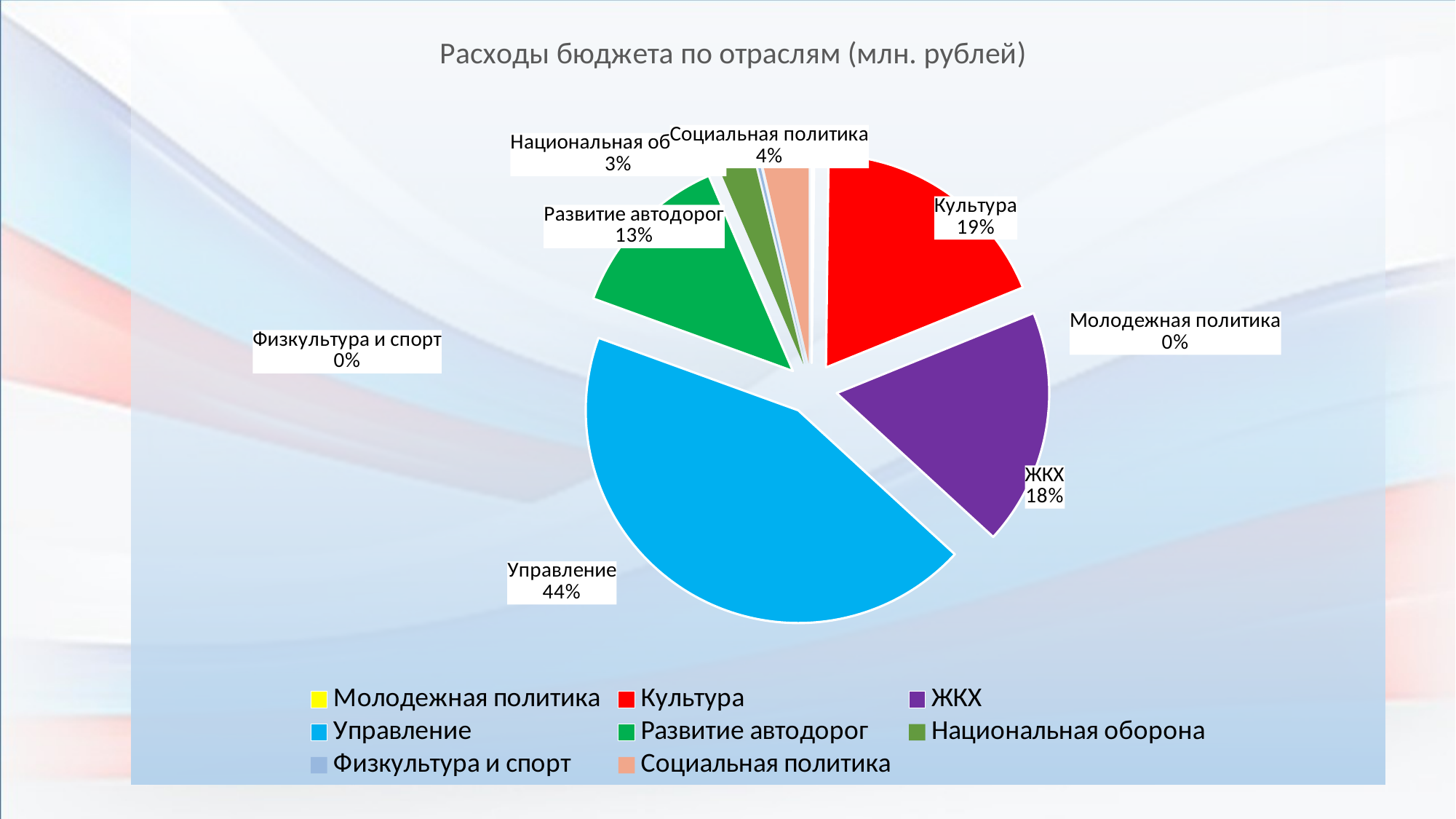
How many categories does the legend list? 8 What percentage is labelled for Социальная политика? 4% What type of chart is shown on the slide? Pie chart Which category has the largest share of the pie? Управление What share of the pie does Управление have? 44% What is the title of the chart? Расходы бюджета по отраслям (млн. рублей) What share is shown for Развитие автодорог? 13% What is the value labelled for ЖКХ? 18% What is the difference in percentage points between Культура and ЖКХ? 1% Which is larger, the share for Культура or the share for ЖКХ? Культура What percentage is shown for Культура? 19% What percentage is shown for Национальная оборона? 3%